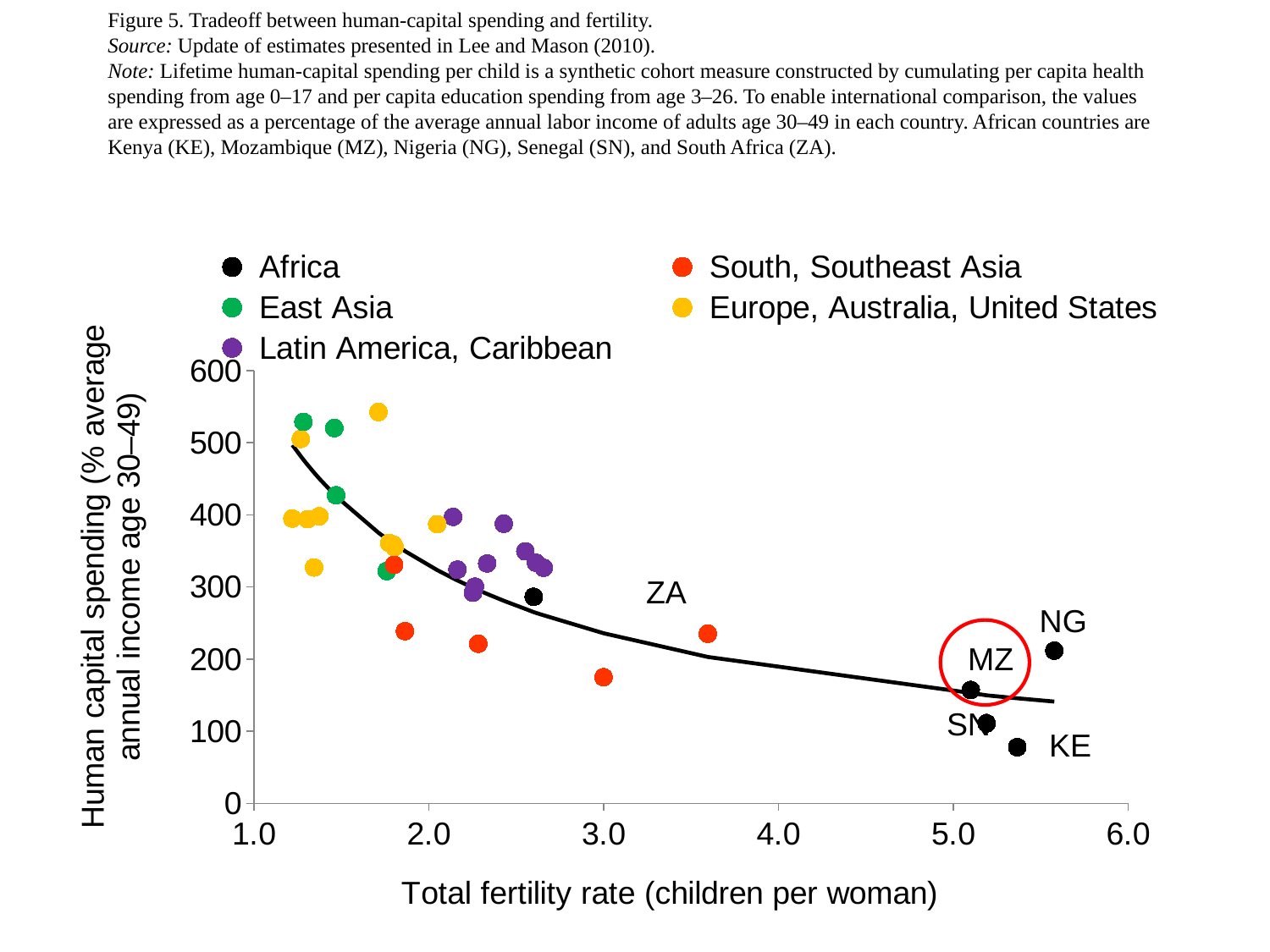
Among the labelled African countries KE, MZ, NG and SN, which has the lowest human capital spending? KE What colour are the East Asia points in the chart? green Which country's point is circled in red on the chart? MZ Which has higher human capital spending, KE or NG? NG Is the total fertility rate for KE greater or less than 5.0? greater Is the human capital spending value for KE greater or less than 100? less Is the human capital spending value for MZ greater or less than 200? less According to the fitted curve, does human capital spending rise or fall as the total fertility rate increases? fall Which has higher human capital spending, MZ or KE? MZ How many series does the legend list? 5 What kind of chart is shown on the slide? scatter chart